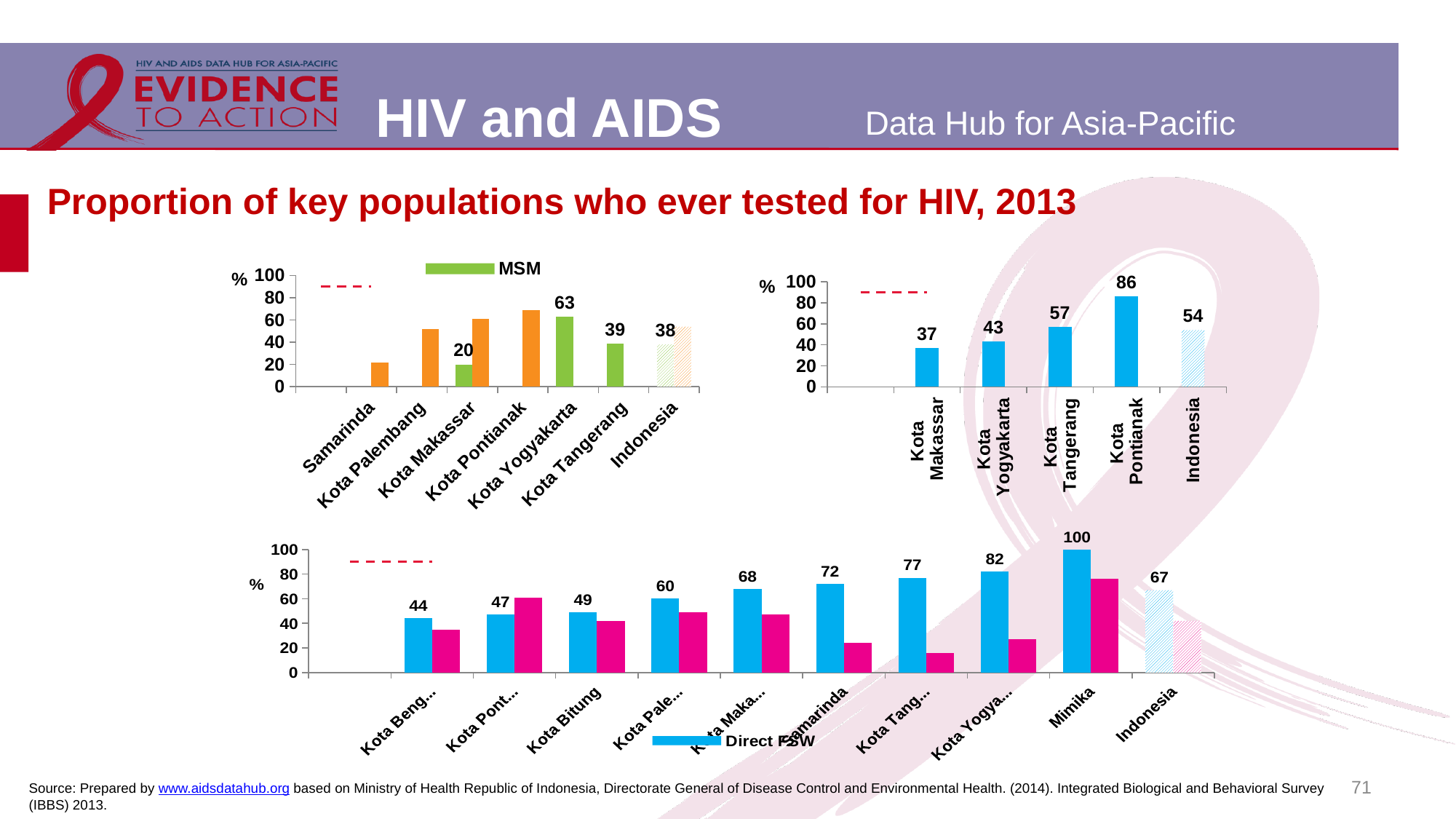
In the top-right chart, which category has the lowest value? Kota Makassar In the bottom chart, what is the Direct FSW value for Mimika? 100 In the top-left chart, is the value for Samarinda greater or less than 40? less In the top-left chart, is the value for Kota Yogyakarta larger or smaller than the value for Kota Tangerang? larger In the top-right chart, what is the difference between the values for Kota Tangerang and Kota Yogyakarta? 14 In the bottom chart, what is the difference between the Direct FSW values for Samarinda and Kota Bitung? 23 In the top-right chart, what is the value for Kota Pontianak? 86 In the top-left chart, what is the value labelled for Kota Makassar? 20 In the top-left chart, what is the MSM value for Kota Yogyakarta? 63 What kind of chart is the bottom chart? bar chart In the top-right chart, which category has the highest value? Kota Pontianak In the top-right chart, how many categories are shown on the x axis? 5